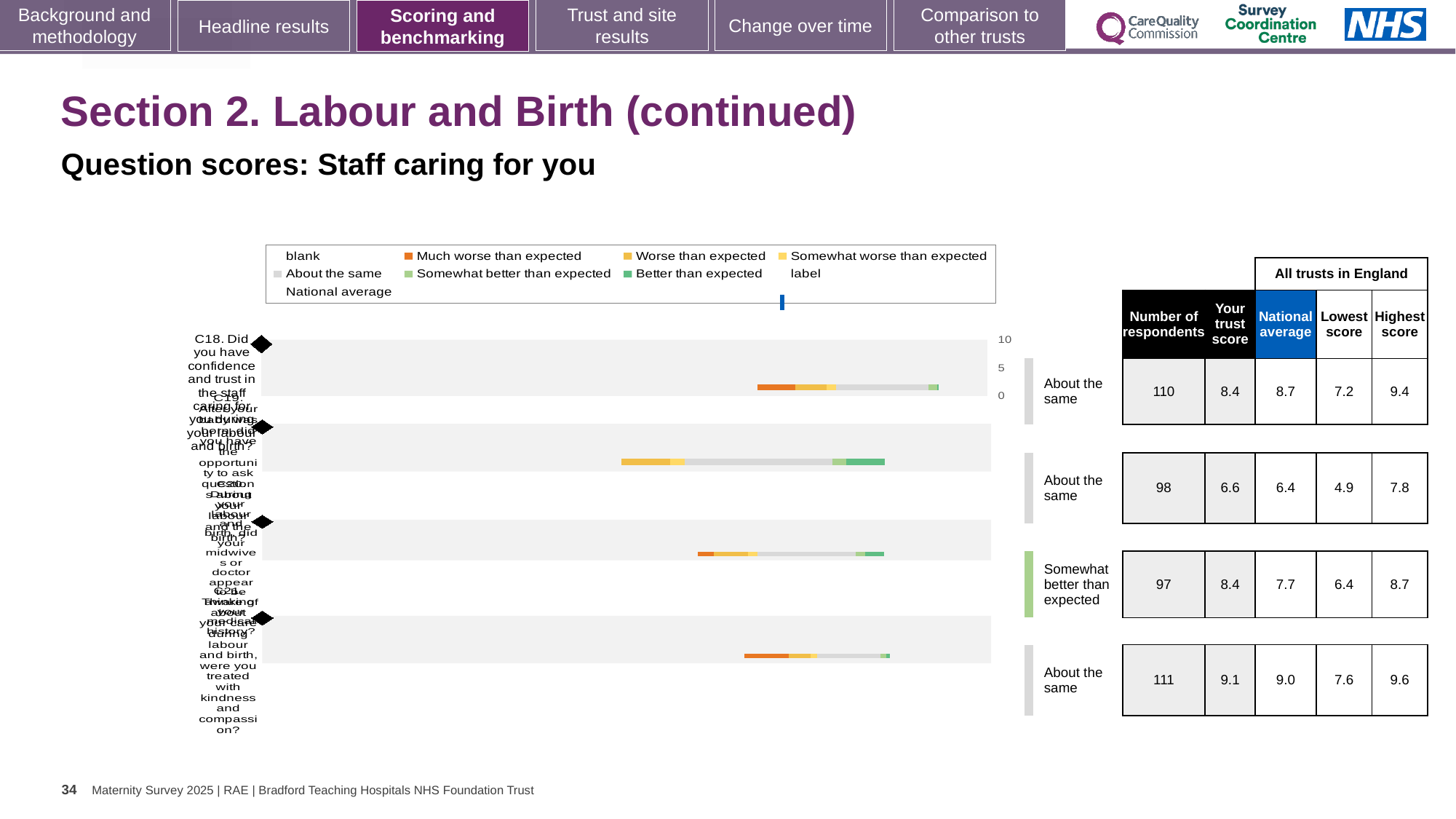
For the top question row, what is the difference between the highest score (9.4) and the lowest score (7.2)? 2.2 How many question rows (bars) are plotted in the chart? 4 In the table beside the chart, what is 'Your trust score' for the top question row (C18)? 8.4 Which question row has the lowest 'Your trust score' in the table beside the chart? the second row, 6.6 In the table beside the chart, what is the national average for the second question row? 6.4 In the table beside the chart, what is the number of respondents for the top question row (C18)? 110 Which question row has the highest 'Your trust score' in the table beside the chart? the bottom (fourth) row, 9.1 What kind of chart is shown on the slide? bar chart In the table beside the chart, what is the highest score for the bottom question row? 9.6 Is the number of respondents larger for the second question row or the third question row? the second row (98) What is the highest value shown on the chart's score axis? 10 What colour does the legend use for 'Much worse than expected'? orange